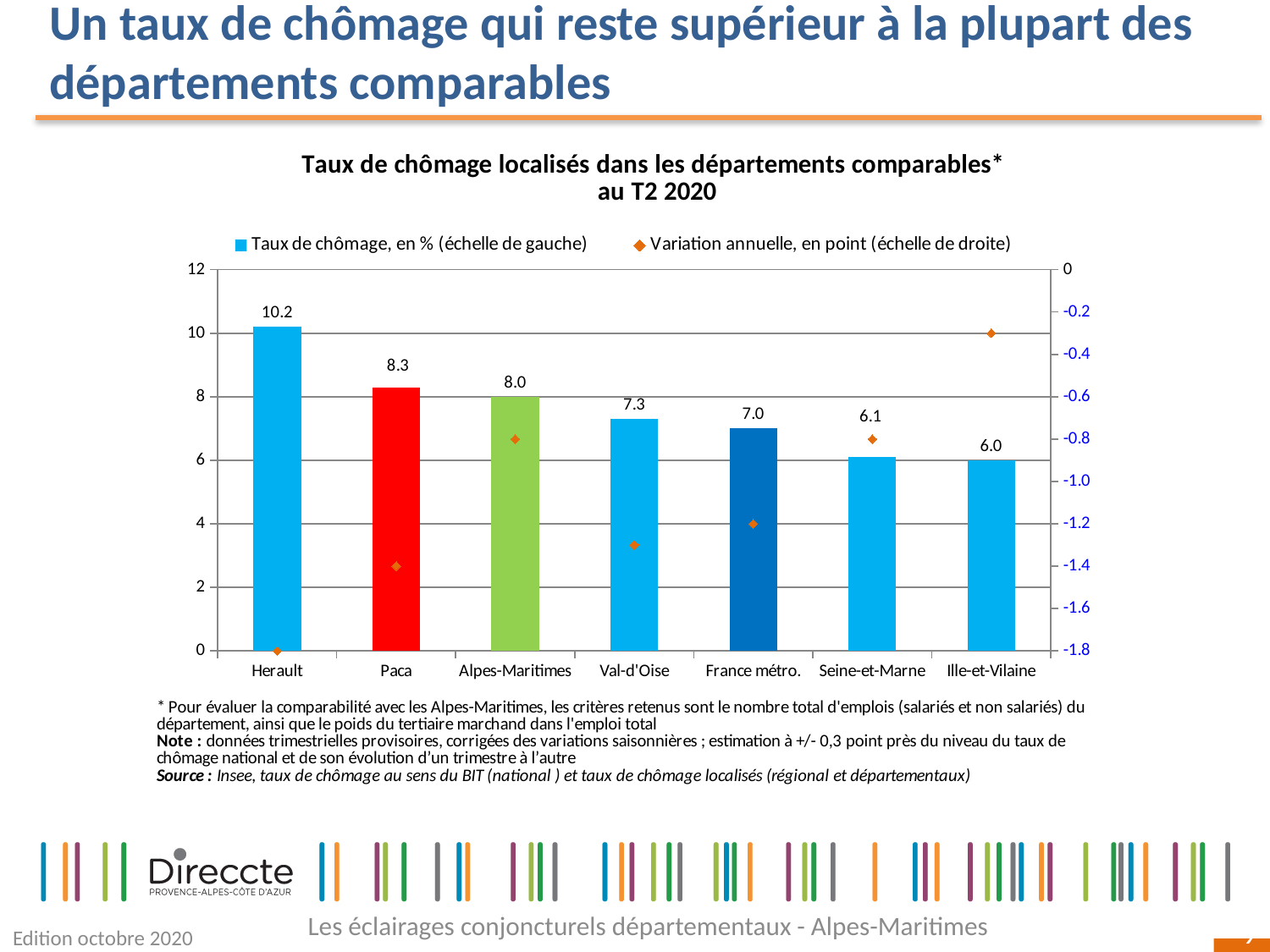
Which department or area has the highest unemployment rate on the chart? Herault What is the unemployment rate shown for France métro.? 7.0 What is the difference between the unemployment rate of Herault and that of Alpes-Maritimes? 2.2 Which department or area has the lowest unemployment rate on the chart? Ille-et-Vilaine Which has a higher unemployment rate, Paca or Val-d'Oise? Paca Is the annual variation (Variation annuelle) for Ille-et-Vilaine greater or less than -0.6? greater What colour is the bar for Paca? Red What is the unemployment rate shown for Alpes-Maritimes? 8.0 How many departments or areas are shown on the x axis? 7 How many series does the legend list? 2 Is the annual variation (Variation annuelle) for Herault greater or less than -1.6? less What is the unemployment rate (Taux de chômage) shown for Herault? 10.2